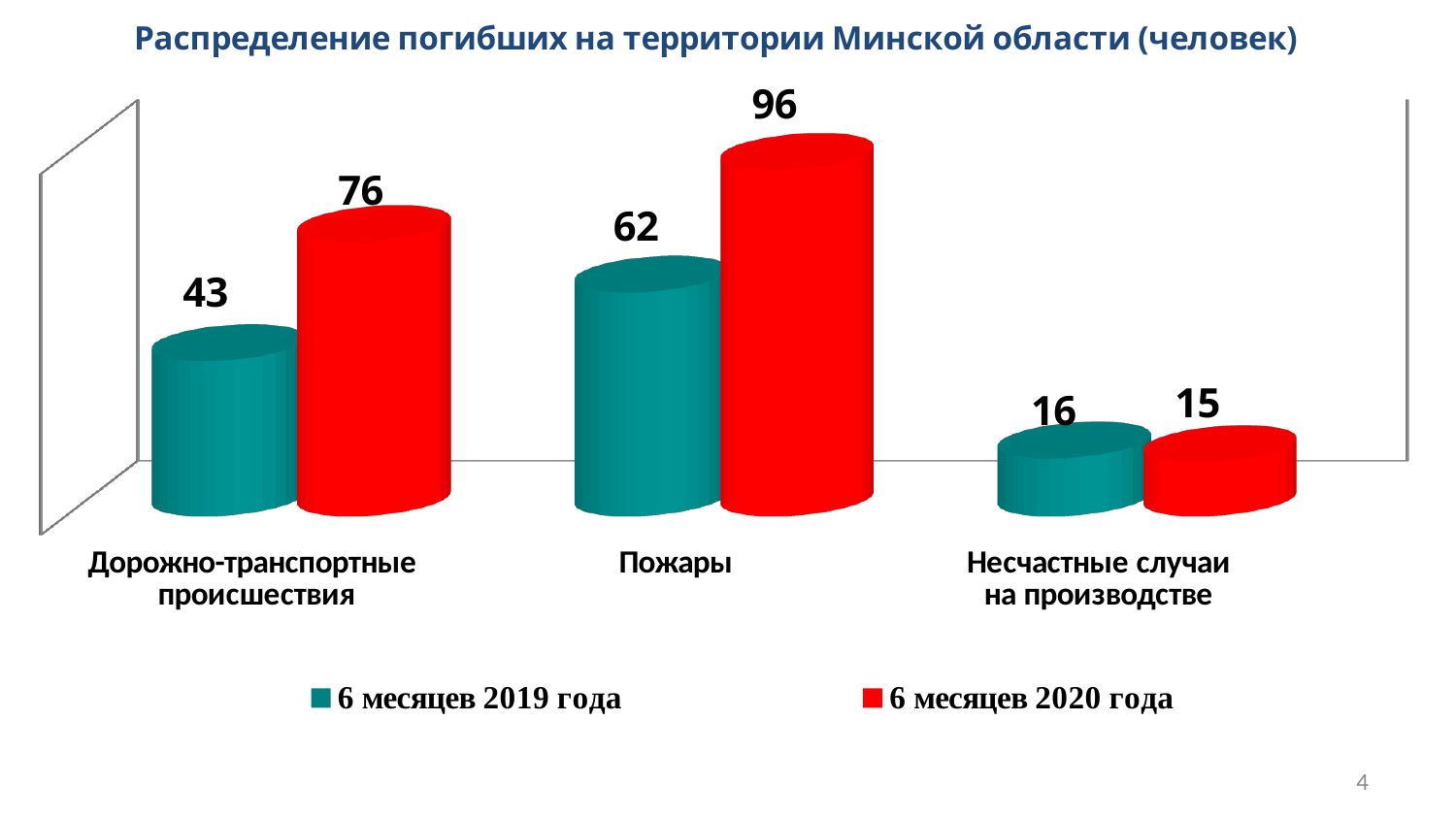
What is the difference between the 6 месяцев 2020 года and 6 месяцев 2019 года values for Пожары? 34 Which category has the lowest value in the 6 месяцев 2019 года series? Несчастные случаи на производстве What is the value for Несчастные случаи на производстве in the 6 месяцев 2019 года series? 16 What is the difference between the 6 месяцев 2020 года and 6 месяцев 2019 года values for Дорожно-транспортные происшествия? 33 How many series does the legend list? 2 Which is larger for Несчастные случаи на производстве: the 6 месяцев 2019 года value or the 6 месяцев 2020 года value? 6 месяцев 2019 года What is the value for Пожары in the 6 месяцев 2020 года series? 96 What is the value for Дорожно-транспортные происшествия in the 6 месяцев 2019 года series? 43 What kind of chart is shown on the slide? bar chart What is the title of the chart? Распределение погибших на территории Минской области (человек) How many categories are shown on the x axis? 3 Which category has the highest value in the 6 месяцев 2020 года series? Пожары